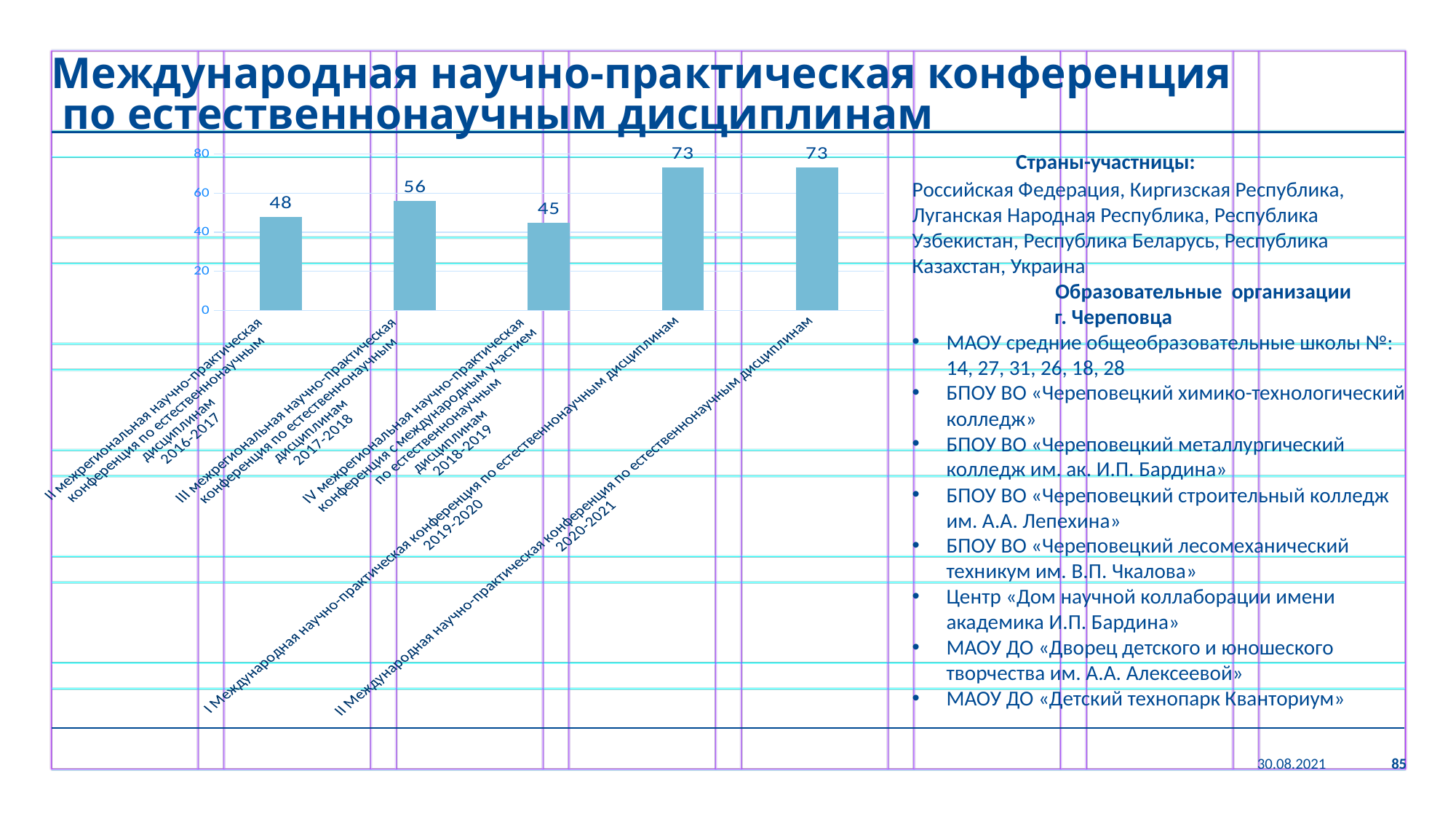
What is the value for the 2016-2017 conference (II межрегиональная научно-практическая конференция)? 48 What is the value for the 2017-2018 conference (III межрегиональная научно-практическая конференция)? 56 How many bars are shown in the chart? 5 What is the value for the 2019-2020 conference (I Международная научно-практическая конференция)? 73 Is the value for 2016-2017 greater or less than 40? greater Which is larger, the value for 2016-2017 or the value for 2017-2018? 2017-2018 What is the highest value shown in the chart? 73 What is the difference between the values for 2020-2021 and 2018-2019? 28 What is the difference between the values for 2017-2018 and 2016-2017? 8 What is the value for the 2018-2019 conference (IV межрегиональная конференция с международным участием)? 45 What kind of chart is shown on the slide? bar chart Which conference year has the lowest value? 2018-2019